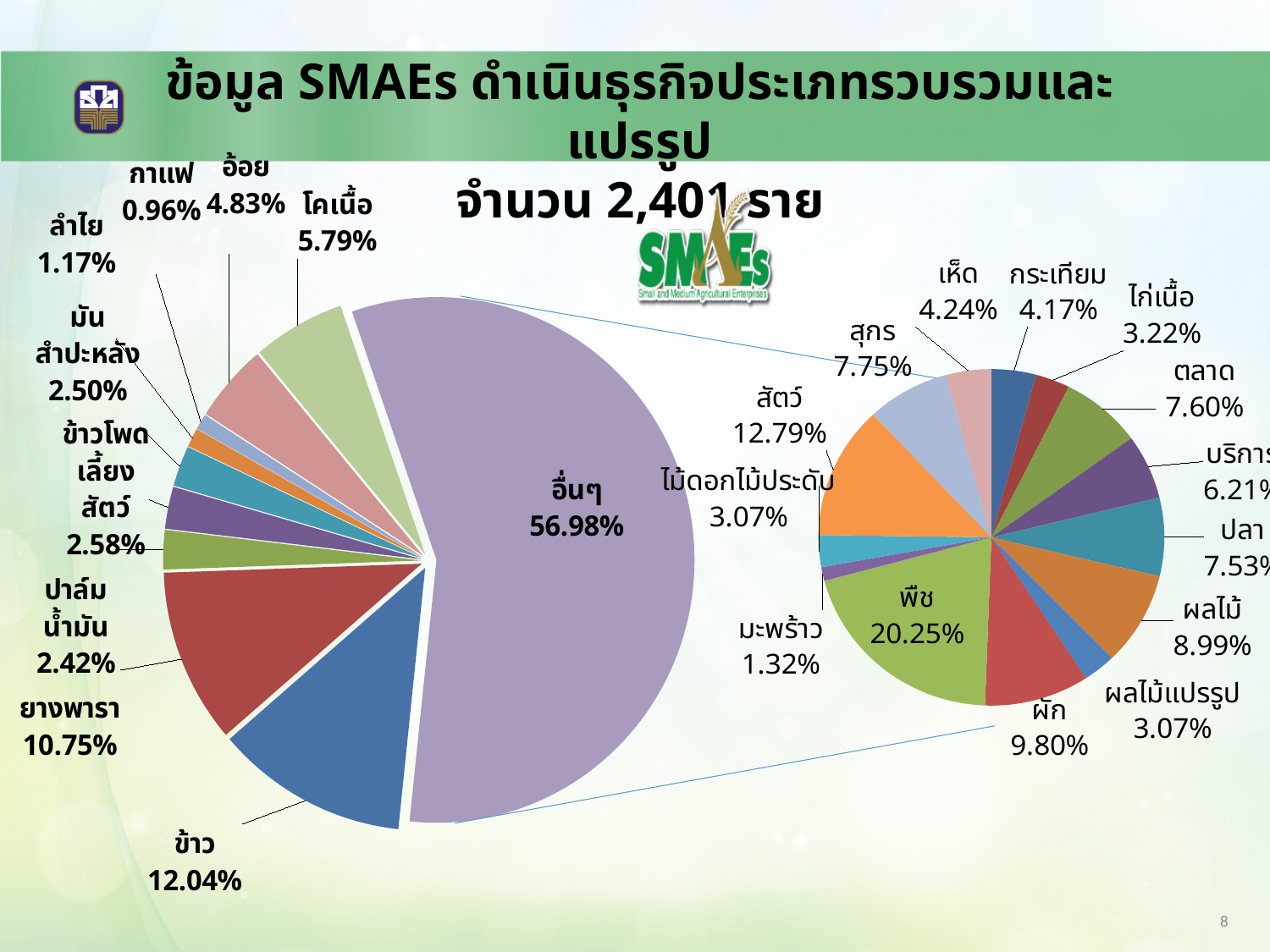
In the large pie chart on the left, what is the share for ยางพารา? 10.75% In the smaller pie chart on the right, which category has the smallest share? มะพร้าว What type of chart is shown on the slide? Pie chart In the smaller pie chart on the right, what is the share for สัตว์? 12.79% In the large pie chart on the left, which category has the largest share? อื่นๆ According to the slide title, how many SMAEs are covered by the data? 2,401 ราย How many categories are shown in the smaller pie chart on the right? 14 In the large pie chart on the left, what is the difference between the shares of ข้าว and ยางพารา? 1.29% In the large pie chart on the left, what is the share for ข้าว? 12.04% In the large pie chart on the left, which category has the smallest share? กาแฟ In the smaller pie chart on the right, what is the share for พืช? 20.25% In the large pie chart on the left, which is larger: โคเนื้อ or อ้อย? โคเนื้อ